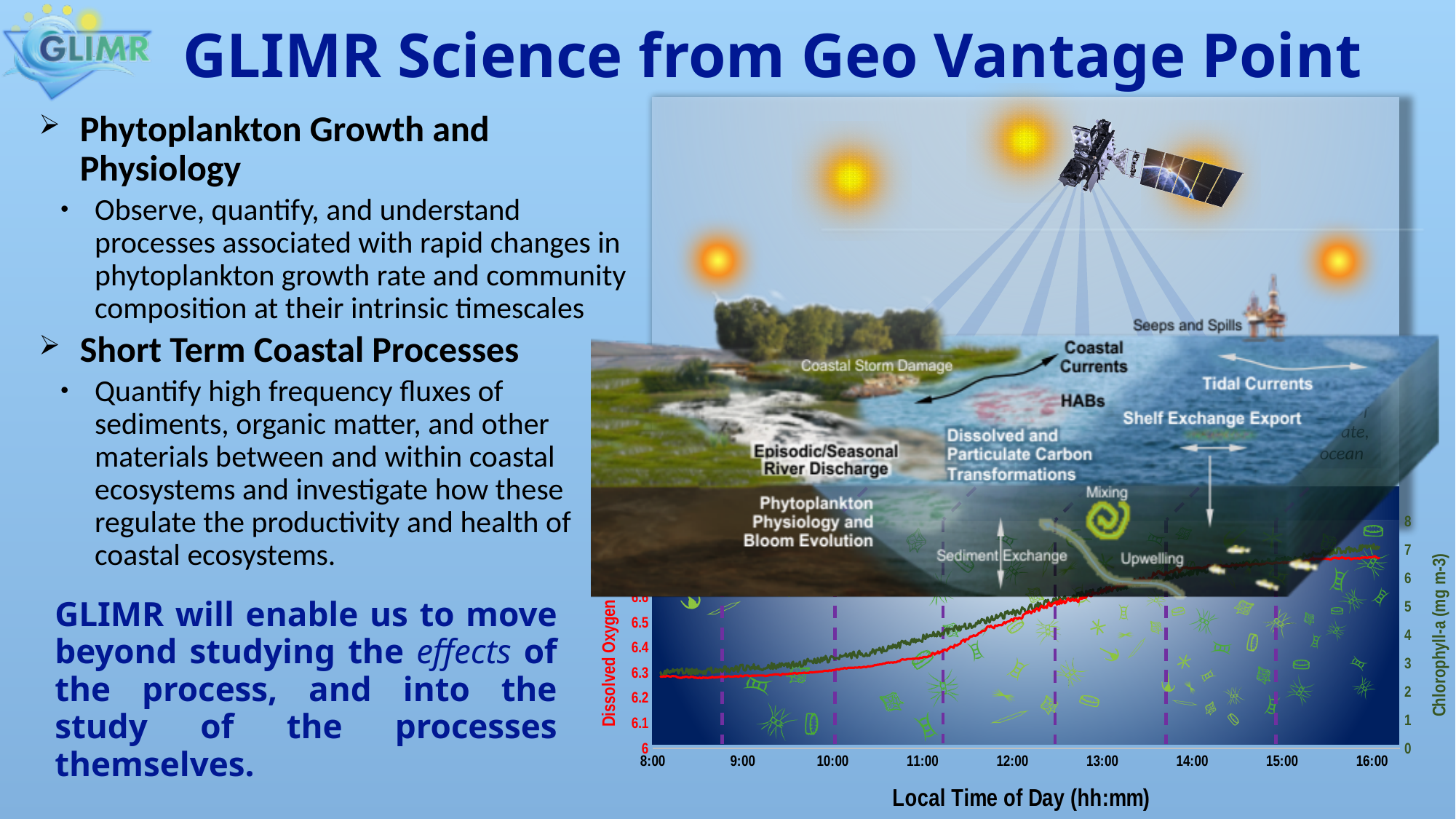
How many time labels are shown along the x-axis of the chart? 9 Is the Dissolved Oxygen value at 12:00 greater or less than 6.3? greater What is the x-axis title of the chart? Local Time of Day (hh:mm) Is the Dissolved Oxygen value at 10:00 greater or less than 6.5? less Does the Dissolved Oxygen line rise or fall from 8:00 to 16:00? rise What kind of chart is shown in the lower right of the slide? line chart What is the last time shown on the x-axis of the chart? 16:00 What is the first time shown on the x-axis of the chart? 8:00 Does the Chlorophyll-a line rise or fall across the day from 8:00 to 16:00? rise Is the Dissolved Oxygen value at 9:00 greater or less than 6.4? less How many lines are plotted on the chart? 2 What quantity is labelled on the right-hand y-axis of the chart? Chlorophyll-a (mg m-3)